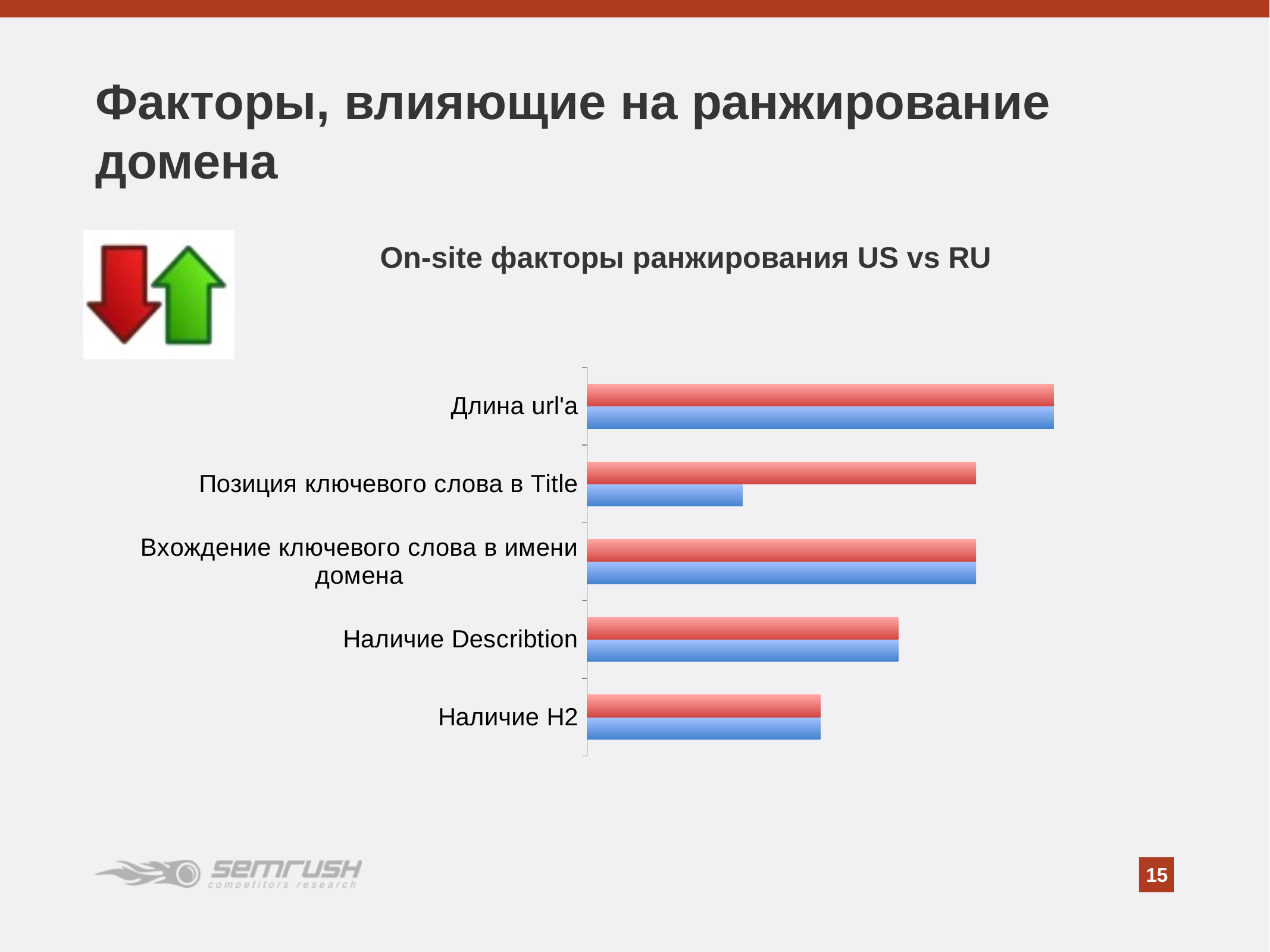
Which category is listed at the bottom of the chart? Наличие H2 What kind of chart is shown on the slide? Bar chart Which has the longer red bar, 'Наличие Describtion' or 'Наличие H2'? Наличие Describtion Which category has the longest red bar? Длина url'a What is the title of the chart? On-site факторы ранжирования US vs RU How many categories (factors) are shown on the chart? 5 Which category has the shortest blue bar? Позиция ключевого слова в Title For 'Позиция ключевого слова в Title', which bar is longer, the red one or the blue one? The red one Which has the longer blue bar, 'Вхождение ключевого слова в имени домена' or 'Наличие Describtion'? Вхождение ключевого слова в имени домена Which category has the shortest red bar? Наличие H2 Which category has the longest blue bar? Длина url'a What two colours are used for the bars in the chart? Red and blue